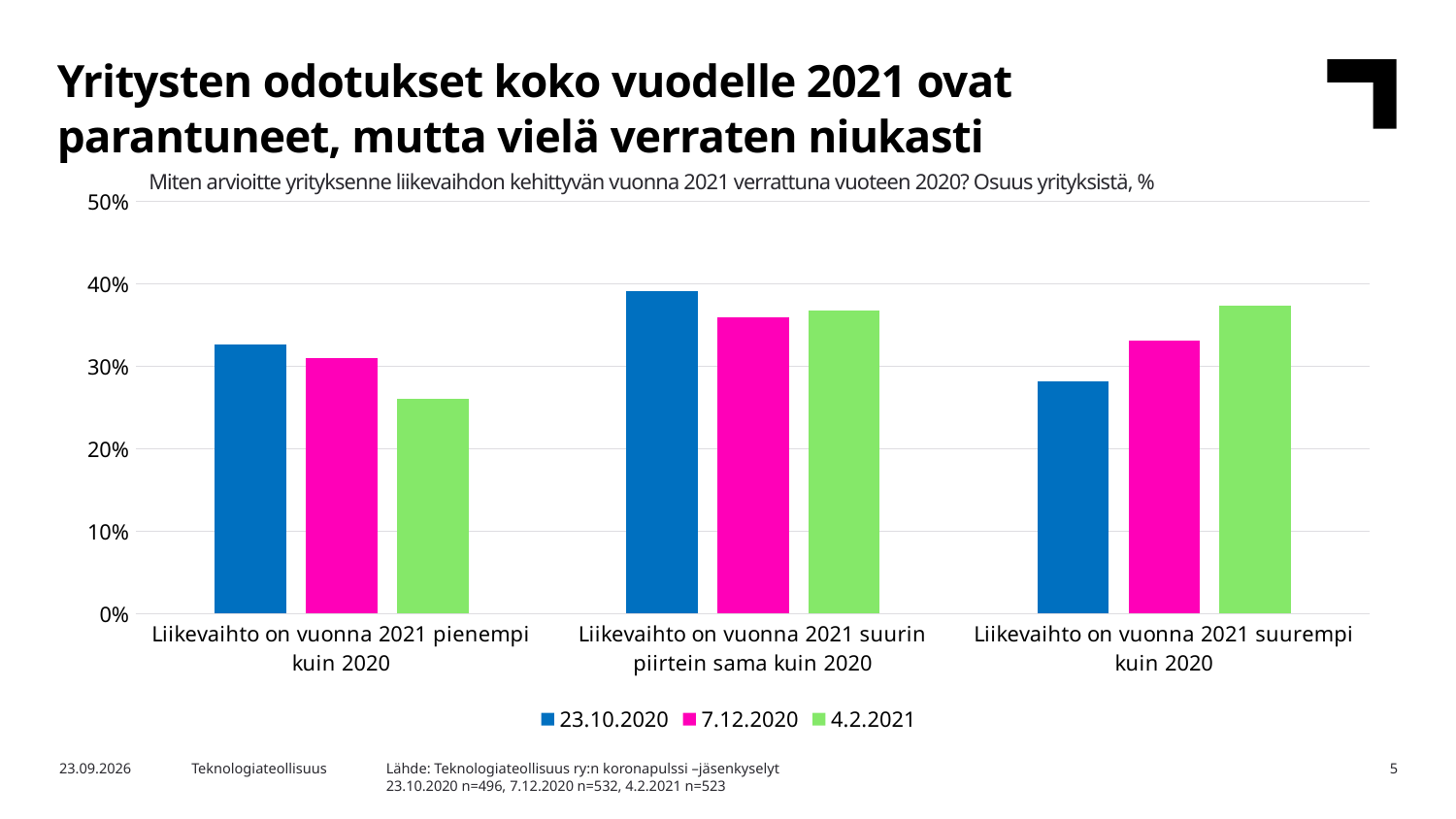
Which series are listed in the chart's legend? 23.10.2020, 7.12.2020, 4.2.2021 What kind of chart is shown on the slide? bar chart Is the value for 23.10.2020 in the category 'Liikevaihto on vuonna 2021 suurin piirtein sama kuin 2020' greater or less than 30%? greater How many categories are shown on the x axis of the chart? 3 Which category has the lowest value for the 23.10.2020 series? Liikevaihto on vuonna 2021 suurempi kuin 2020 Is the value for 4.2.2021 in the category 'Liikevaihto on vuonna 2021 suurempi kuin 2020' greater or less than 30%? greater Which category has the highest value for the 23.10.2020 series? Liikevaihto on vuonna 2021 suurin piirtein sama kuin 2020 In the category 'Liikevaihto on vuonna 2021 suurempi kuin 2020', which is larger: the value for 23.10.2020 or the value for 4.2.2021? 4.2.2021 How many series does the chart's legend list? 3 Is the value for 23.10.2020 in the category 'Liikevaihto on vuonna 2021 suurempi kuin 2020' greater or less than 30%? less In the category 'Liikevaihto on vuonna 2021 pienempi kuin 2020', do the values rise or fall from 23.10.2020 to 4.2.2021? fall